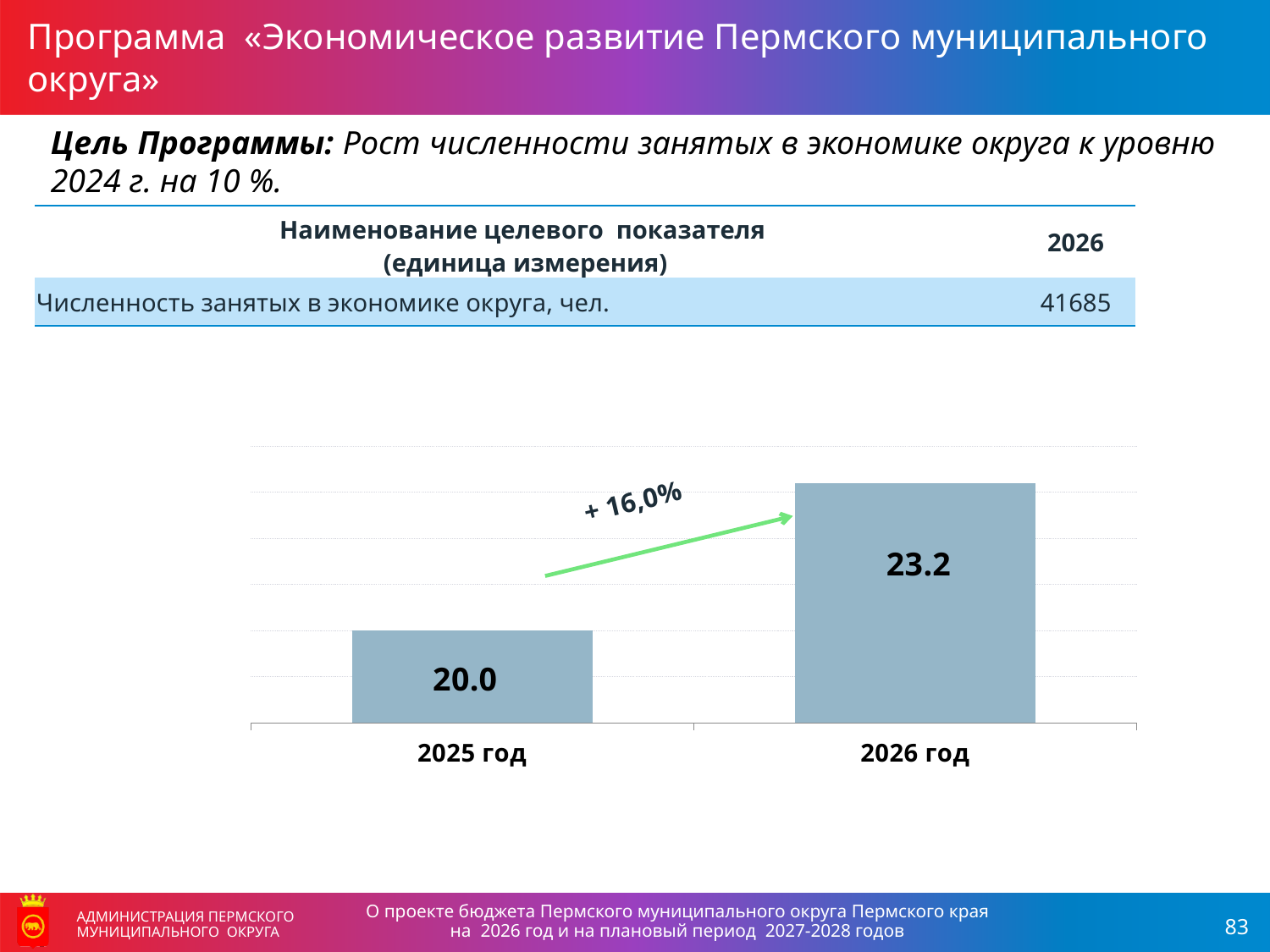
What is the value shown for 2026 год? 23.2 What is the difference between the 2026 год and 2025 год values? 3.2 Which year has the lower bar? 2025 год What is the value shown for 2025 год? 20.0 What is the total of the two bar values? 43.2 Which year has the higher bar? 2026 год How many bars are plotted in the chart? 2 What kind of chart is shown on the slide? bar chart Is the value for 2026 год larger or smaller than the value for 2025 год? larger What percentage change is written next to the arrow between the two bars? + 16,0% Do the values rise or fall from 2025 год to 2026 год? rise